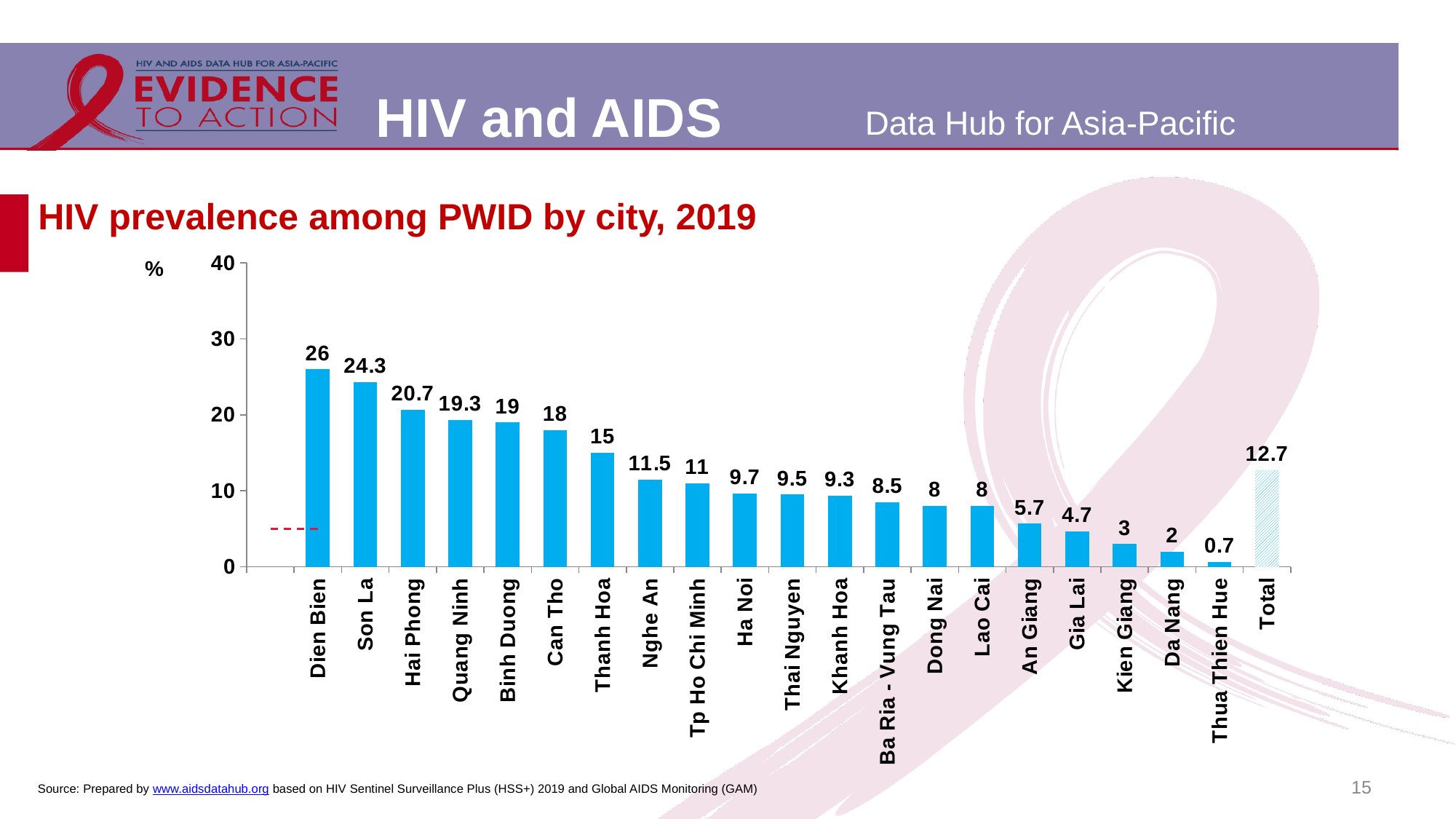
Is the value for Can Tho greater or less than 20? less Which city has the lowest HIV prevalence among PWID? Thua Thien Hue What kind of chart is shown on the slide? Bar chart What is the value shown for Total? 12.7 Do the city values rise or fall from left to right along the x axis? Fall Which city has the highest HIV prevalence among PWID? Dien Bien What is the HIV prevalence among PWID in Tp Ho Chi Minh? 11 What is the difference between the values for Son La and Hai Phong? 3.6 Which has a higher HIV prevalence among PWID, Ha Noi or Thai Nguyen? Ha Noi What is the title of the chart? HIV prevalence among PWID by city, 2019 What is the HIV prevalence among PWID in Dien Bien? 26 How many cities are shown on the chart, excluding the Total bar? 20